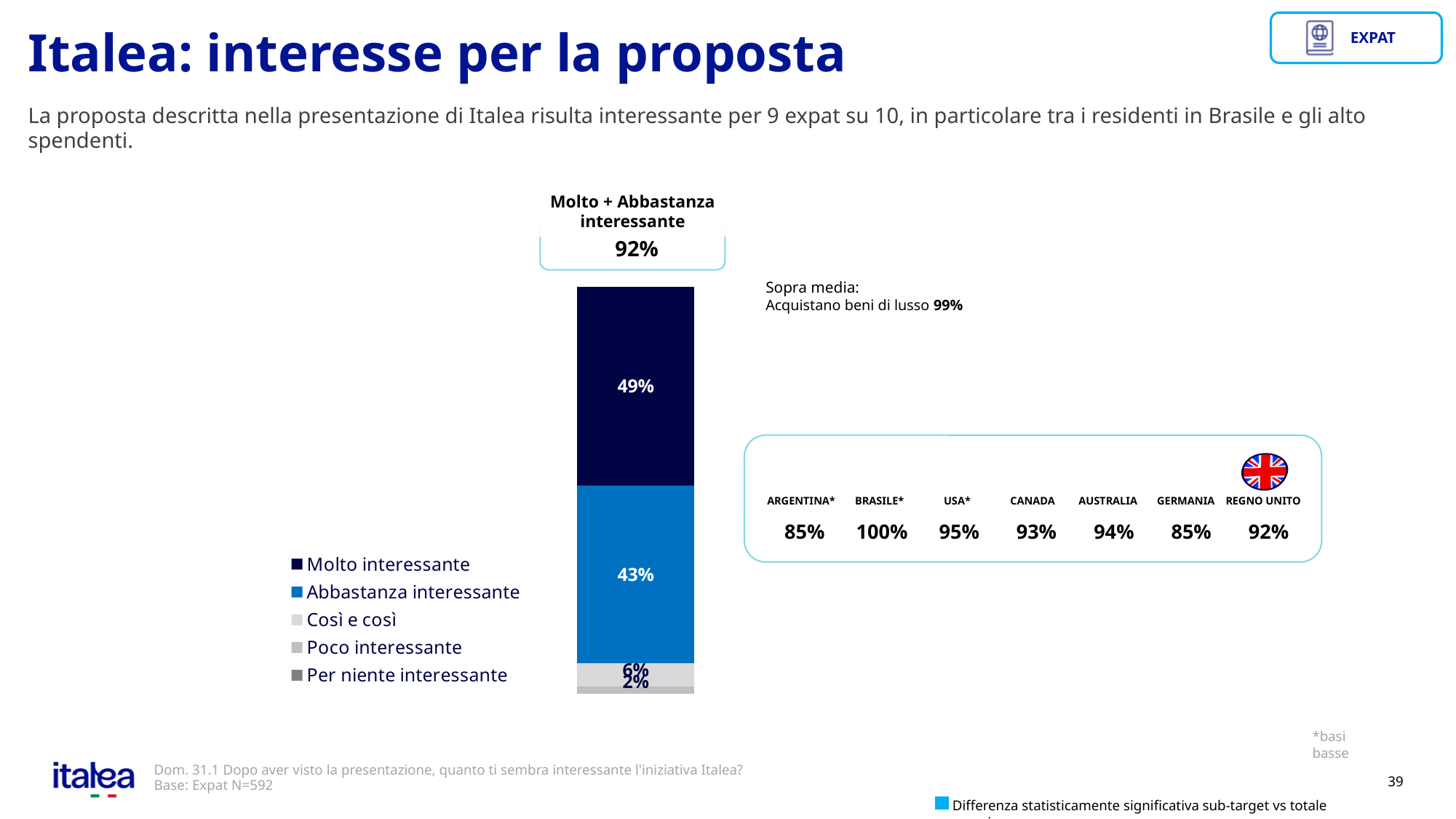
Which is larger, the share for 'Molto interessante' or for 'Abbastanza interessante'? Molto interessante How many series does the chart legend list? 5 What kind of chart is shown on the slide? Stacked bar chart Which response category has the largest share in the stacked bar? Molto interessante Which legend entry is listed last? Per niente interessante What is the combined share for 'Molto + Abbastanza interessante' shown above the bar? 92% What percentage of expats found the proposal 'Molto interessante'? 49% How many stacked bars does the chart contain? 1 What is the difference between the 'Molto interessante' share and the 'Abbastanza interessante' share? 6 percentage points What percentage of expats found the proposal 'Abbastanza interessante'? 43% What percentage is shown for 'Così e così'? 6% What colour is used for the 'Molto interessante' segment? Dark navy blue